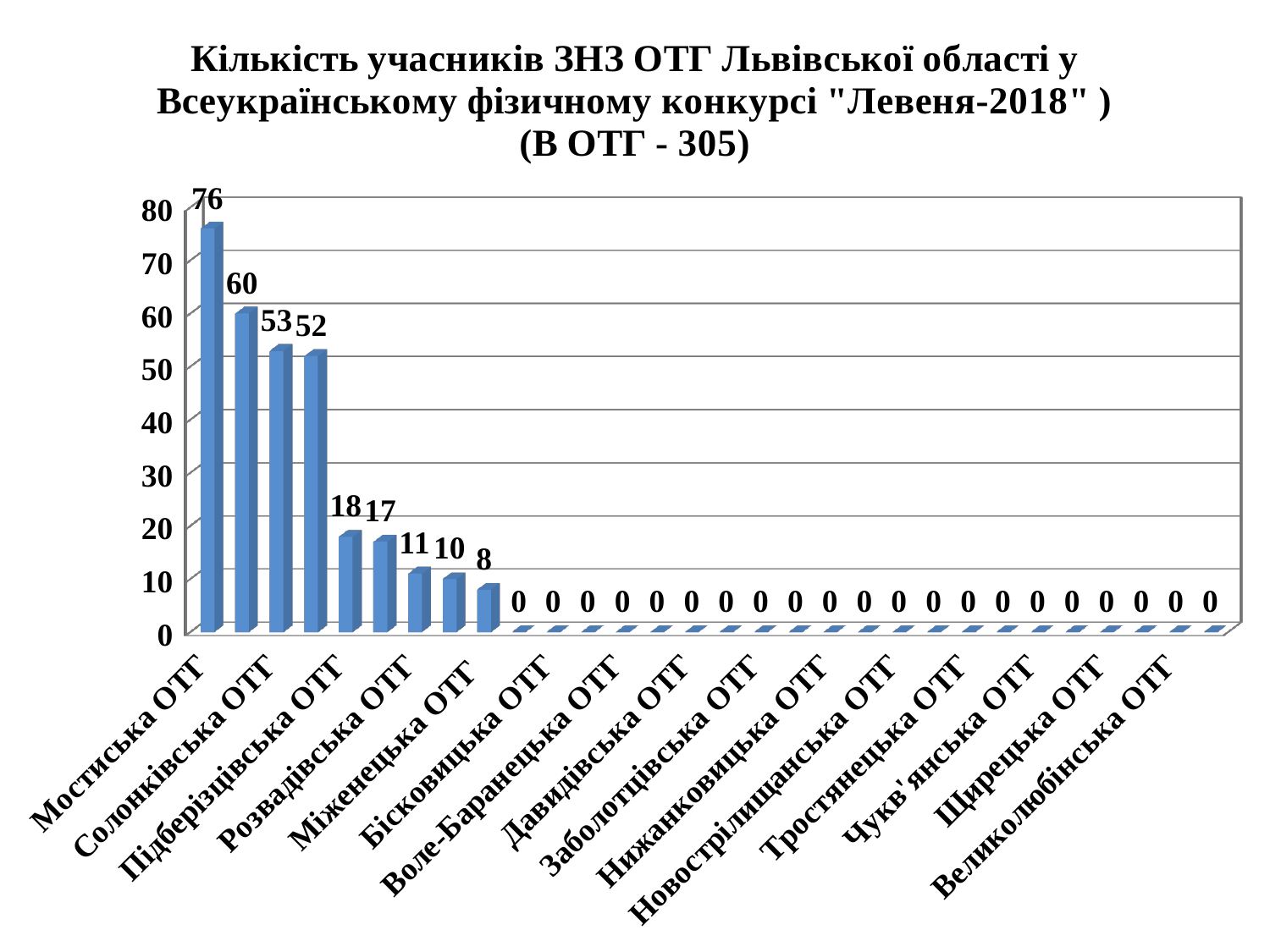
How many bars are plotted in the chart in total? 30 What is the value for Мостиська ОТГ? 76 What is the total number of participants stated in the chart title (В ОТГ)? 305 What is the value of the tallest bar in the chart? 76 What is the difference between the two highest values in the chart? 16 Which category has the highest value in the chart? Мостиська ОТГ What kind of chart is shown on the slide? bar chart How many bars in the chart have a value of 0? 21 Is the value for Мостиська ОТГ greater or less than 70? greater What is the value of the second bar from the left? 60 Do the values rise or fall from left to right along the x axis? fall What is the highest value shown on the vertical axis? 80